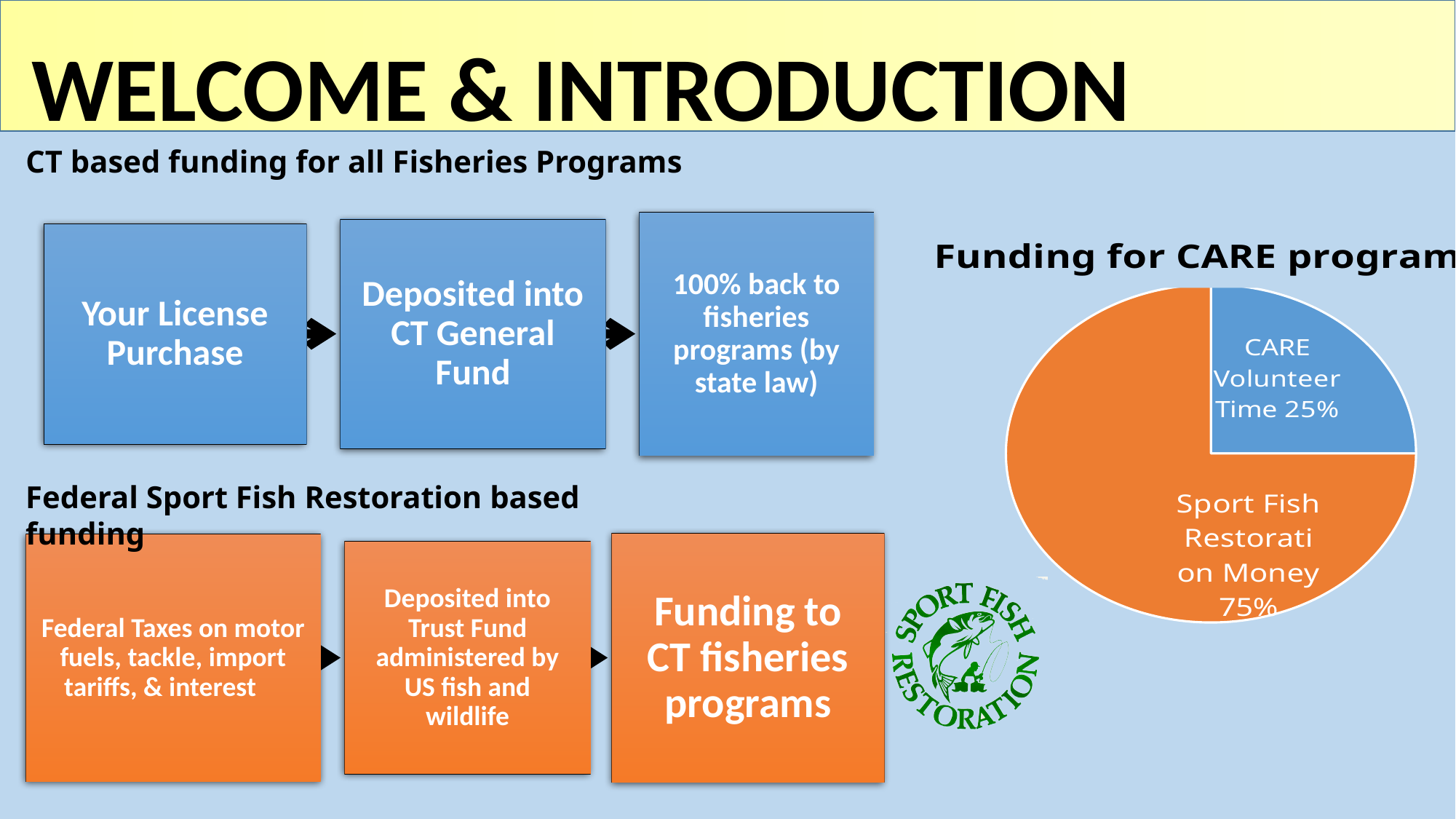
What is the difference in percentage points between the Sport Fish Restoration Money slice and the CARE Volunteer Time slice? 50 Which is larger in the pie chart: CARE Volunteer Time or Sport Fish Restoration Money? Sport Fish Restoration Money What is the title of the pie chart? Funding for CARE program What kind of chart is shown under the title "Funding for CARE program"? pie chart What share of the pie does CARE Volunteer Time represent? 25% Which slice of the pie chart is the smallest? CARE Volunteer Time What colour is the Sport Fish Restoration Money slice of the pie chart? orange How many slices does the pie chart have? 2 What share of the pie does Sport Fish Restoration Money represent? 75% Which slice of the pie chart is the largest? Sport Fish Restoration Money